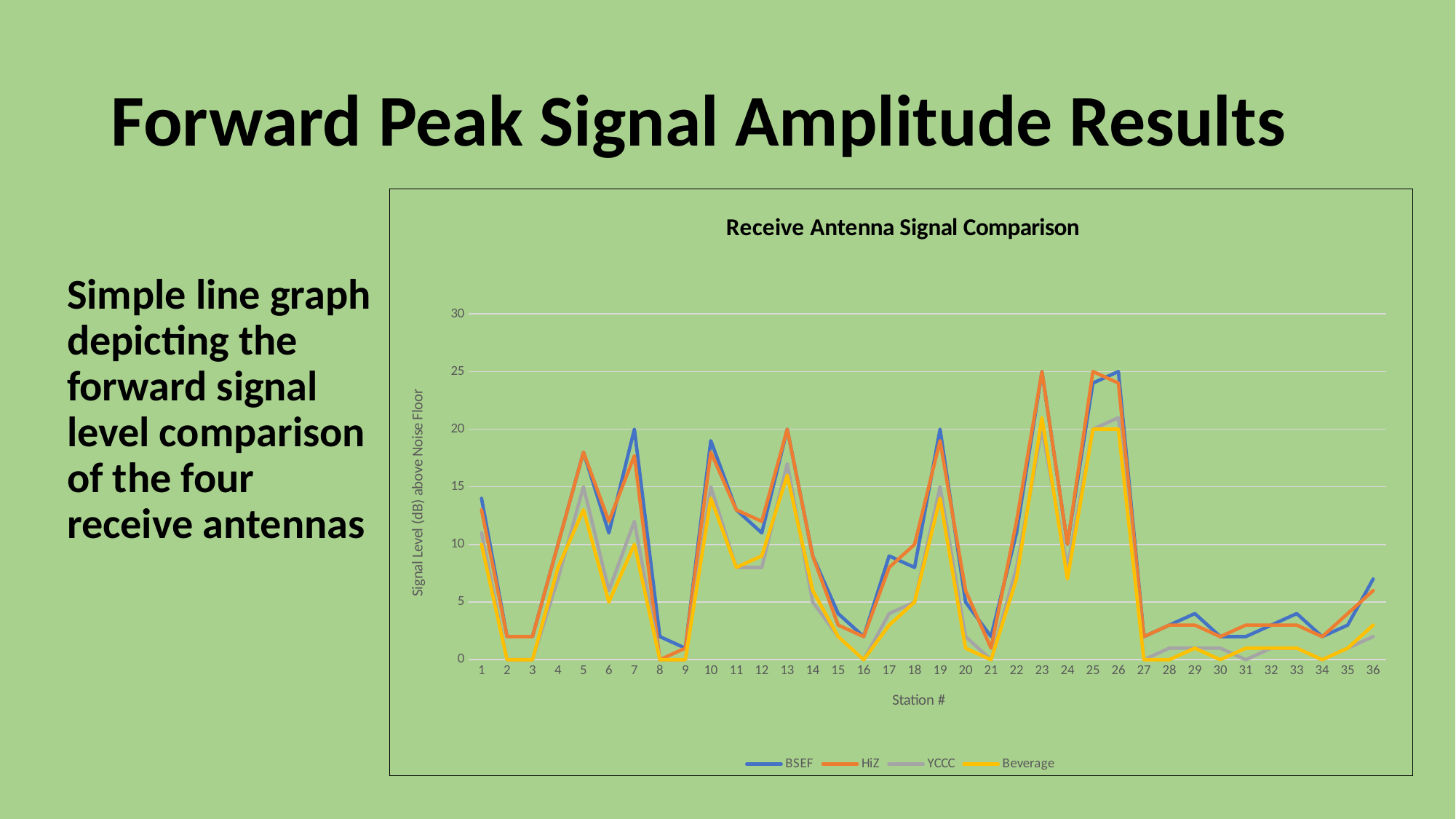
What is the title of the chart? Receive Antenna Signal Comparison How many stations are plotted along the x axis of the chart? 36 At station 5, which is larger, the HiZ value or the YCCC value? HiZ What is the Beverage value at station 8? 0 What is the HiZ value at station 23? 25 Do the values of all four series rise or fall from station 26 to station 27? fall What kind of chart is shown on the slide? line chart What is the BSEF value at station 7? 20 What is the label of the vertical axis of the chart? Signal Level (dB) above Noise Floor Is the BSEF value at station 1 greater or less than 10? greater Is the Beverage value at station 5 greater or less than 15? less How many series does the legend of the chart list? 4